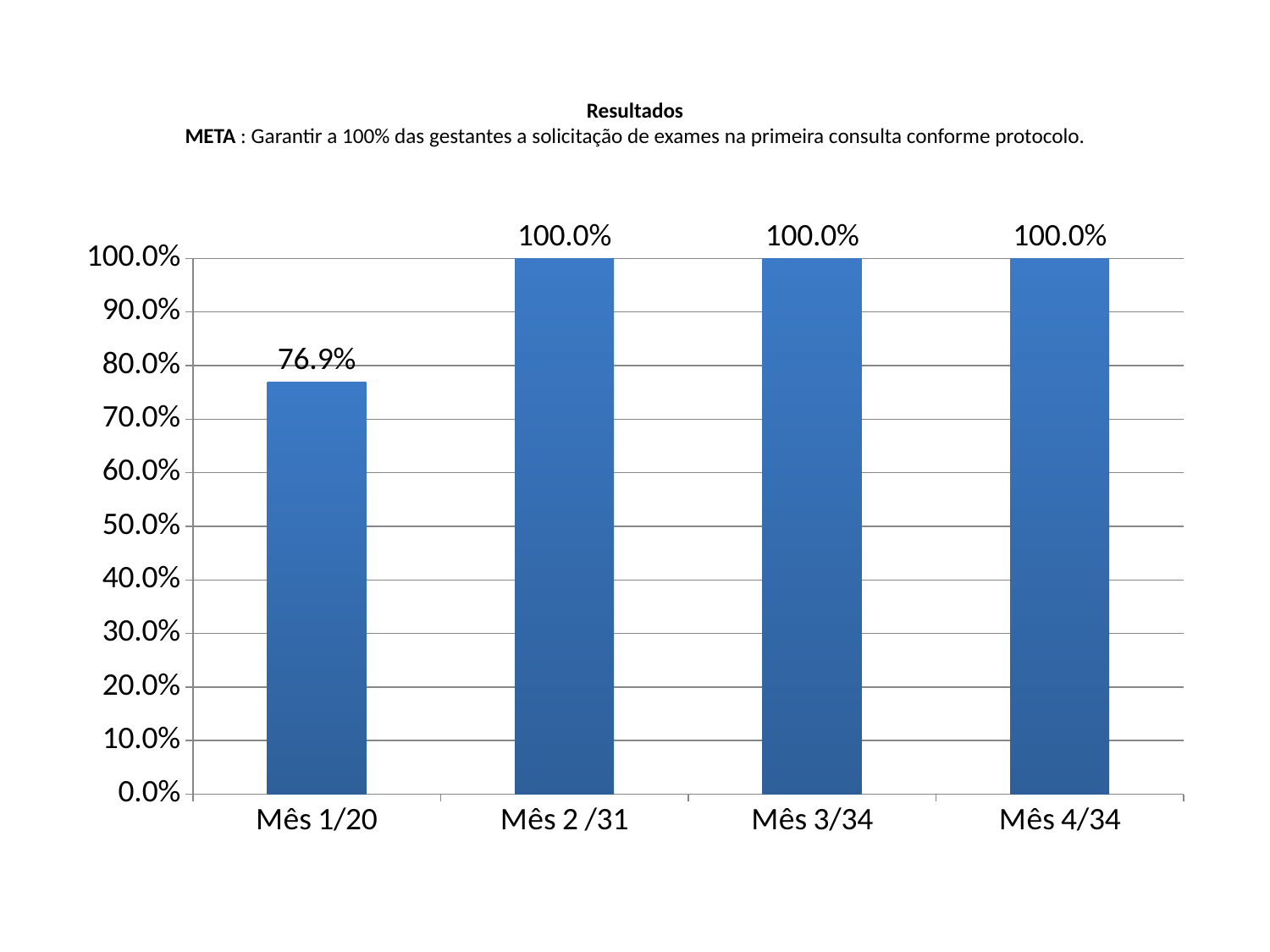
Which is larger, the value for Mês 1/20 or the value for Mês 3/34? Mês 3/34 What is the title of the chart? Resultados What is the highest value shown on the y axis? 100.0% What is the value for Mês 1/20? 76.9% What is the value for Mês 4/34? 100.0% What is the value for Mês 2 /31? 100.0% Which category has the lowest value? Mês 1/20 What is the difference between the values for Mês 2 /31 and Mês 1/20? 23.1% How many categories are shown on the x axis? 4 Do the values rise or fall from Mês 1/20 to Mês 2 /31? rise Is the value for Mês 1/20 greater or less than 80.0%? less What kind of chart is shown on the slide? bar chart